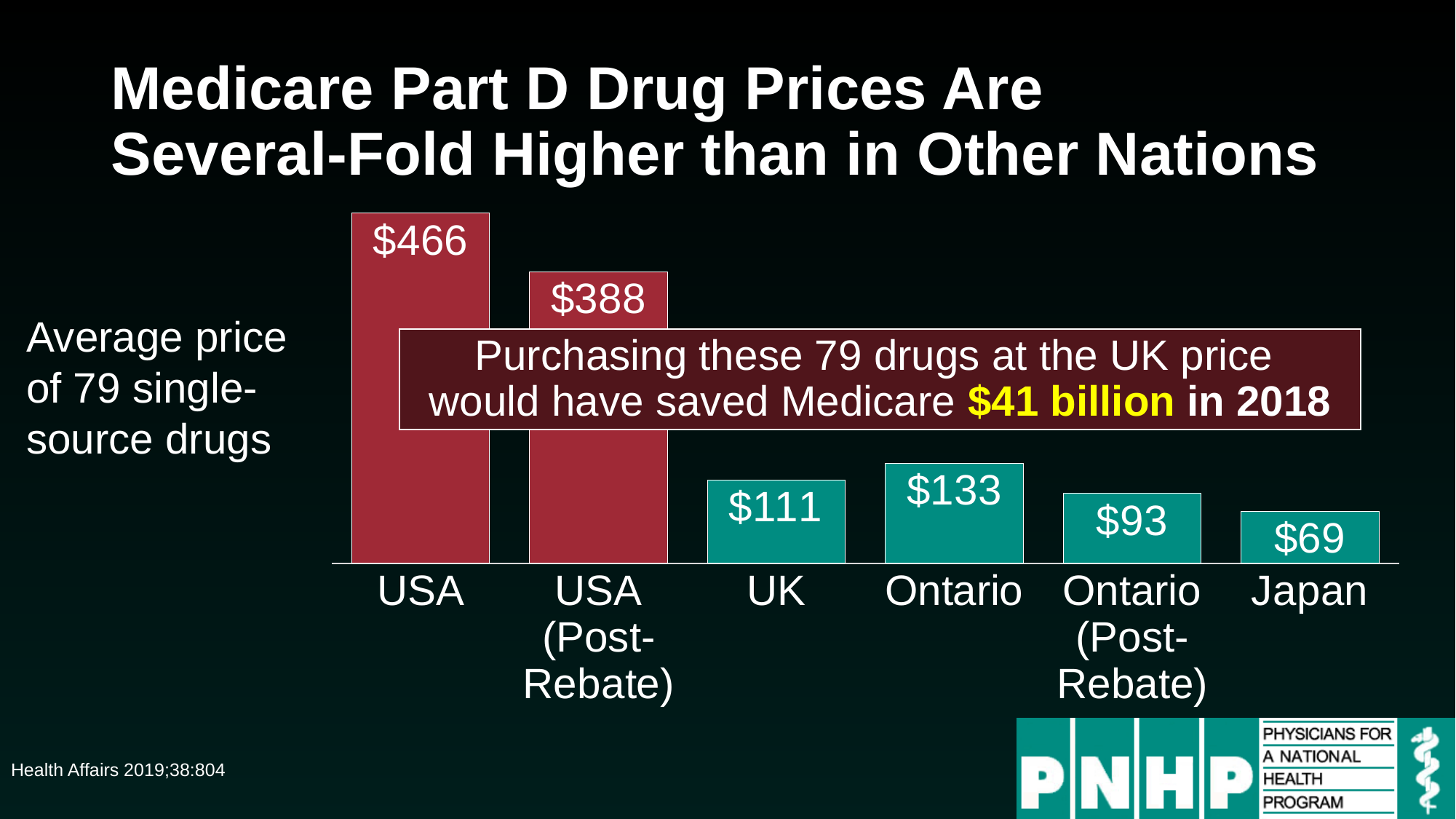
Which category has the highest average price? USA According to the text box on the chart, how much would Medicare have saved in 2018 by purchasing these 79 drugs at the UK price? $41 billion Which category has the lowest average price? Japan What is the difference between the USA price and the USA (Post-Rebate) price? $78 Which is larger, the price for Ontario or the price for the UK? Ontario What kind of chart is shown on the slide? Bar chart How many categories are shown in the bar chart? 6 What is the difference between the Ontario price and the UK price? $22 What is the average price shown for Ontario (Post-Rebate)? $93 What is the average price shown for Japan? $69 What is the average price of the 79 single-source drugs for the USA? $466 What is the average price shown for the UK? $111